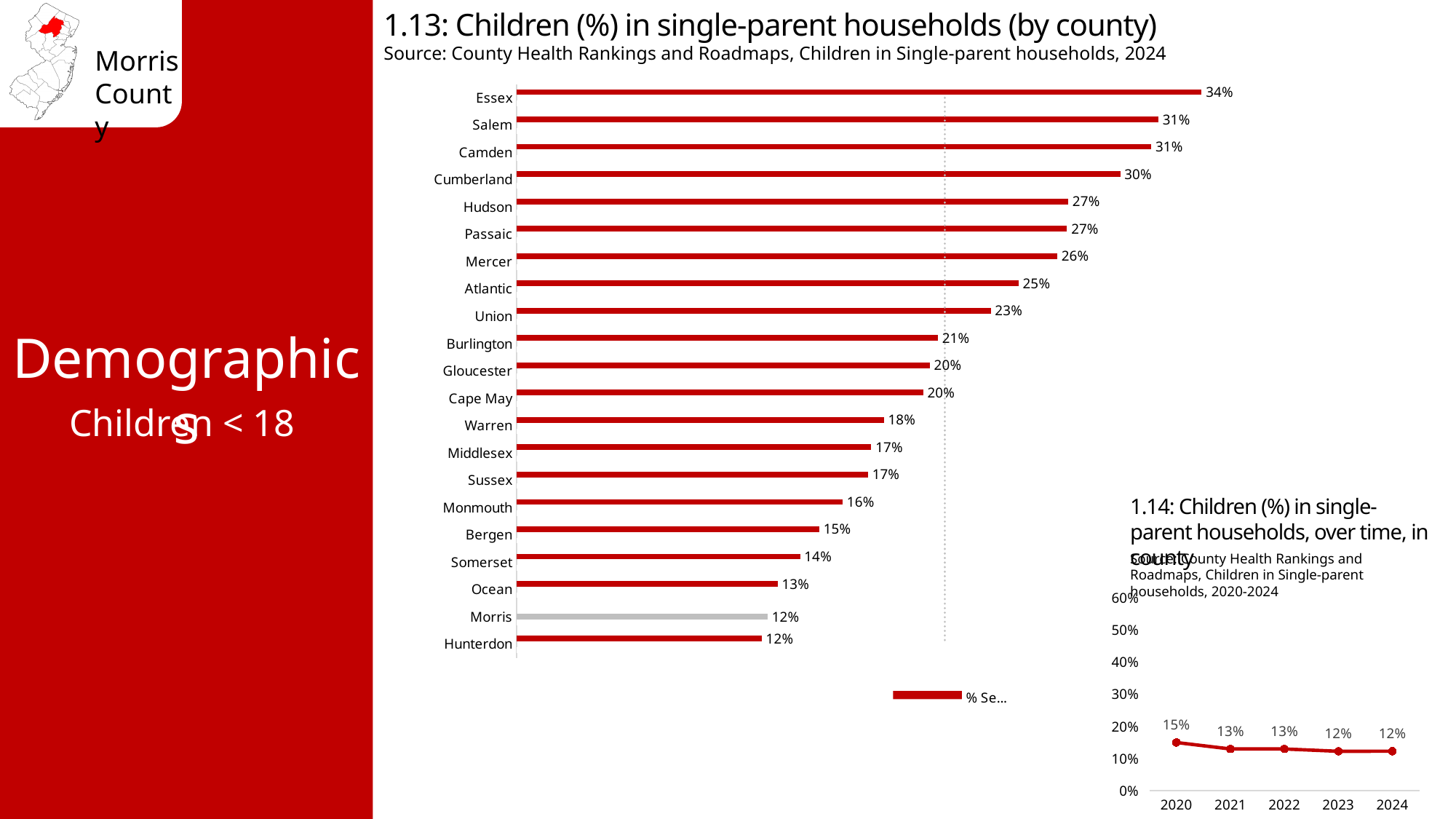
In chart 1.13, what is the value for Cumberland? 30% In chart 1.13, how many counties are shown? 21 In chart 1.13, what is the value for Essex? 34% In chart 1.14, how many years are plotted? 5 In chart 1.13, which county has the highest percentage of children in single-parent households? Essex In chart 1.14, what is the value for 2020? 15% In chart 1.13, what is the value for Morris? 12% In chart 1.13, what is the difference between the values for Essex and Morris? 22 percentage points In chart 1.13, which is larger, the value for Hudson or the value for Union? Hudson In chart 1.14, do the values rise or fall from 2020 to 2024? Fall In chart 1.13, which bar is shown in grey rather than red? Morris What kind of chart is chart 1.13? Bar chart